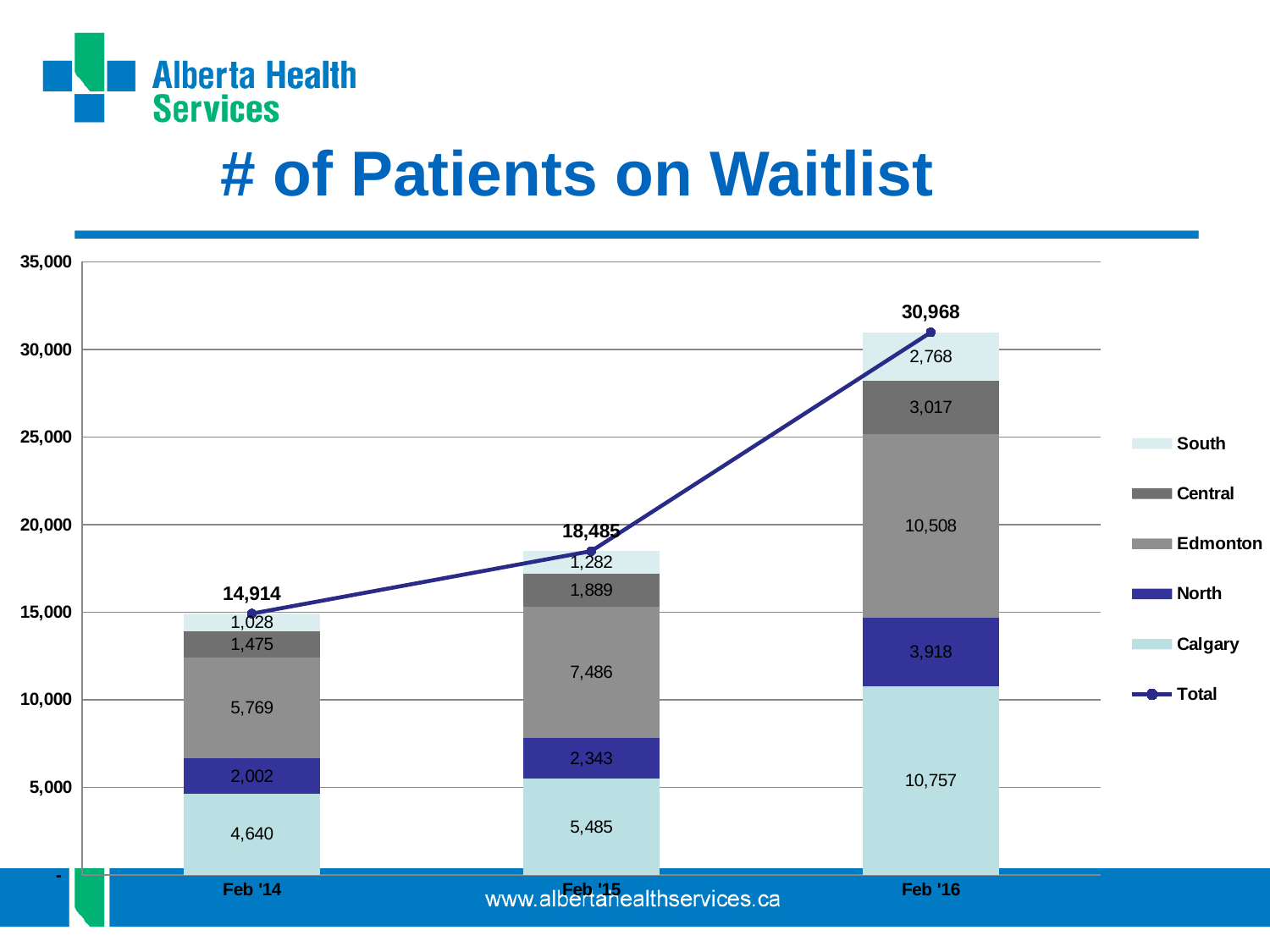
Which period has the highest total number of patients on the waitlist? Feb '16 Does the total number of patients on the waitlist rise or fall from Feb '14 to Feb '16? Rise What is the North value for Feb '16? 3,918 Which is larger in Feb '16: the Calgary value or the Edmonton value? Calgary Which period has the lowest total number of patients on the waitlist? Feb '14 What is the difference between the total waitlist in Feb '16 and Feb '15? 12,483 How many periods are shown on the x axis? 3 What is the Calgary value for Feb '14? 4,640 What kind of chart is this? Stacked bar chart with a line How many entries does the legend list? 6 What is the total number of patients on the waitlist in Feb '16? 30,968 What is the Edmonton value for Feb '15? 7,486